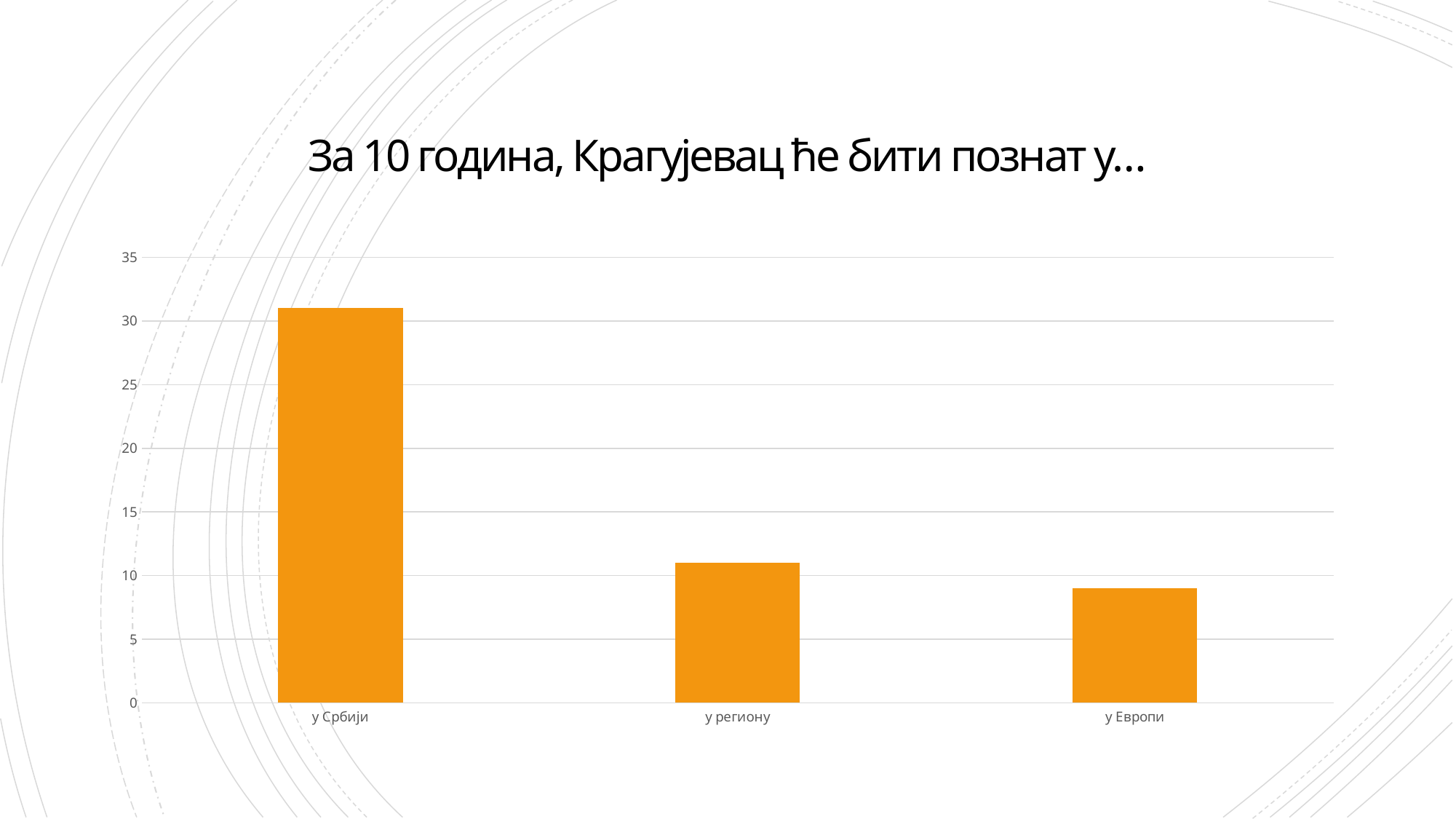
Is the value for у Европи greater or less than 10? less Is the value for у Србији greater or less than 25? greater Which category has the highest bar in the chart? у Србији Is the value for у Европи greater or less than 5? greater How many categories are shown on the x axis of the chart? 3 What is the title of the chart on the slide? За 10 година, Крагујевац ће бити познат у… Which is larger, the value for у Србији or the value for у региону? у Србији Which category has the lowest bar in the chart? у Европи Which is larger, the value for у региону or the value for у Европи? у региону What kind of chart is shown on the slide? bar chart